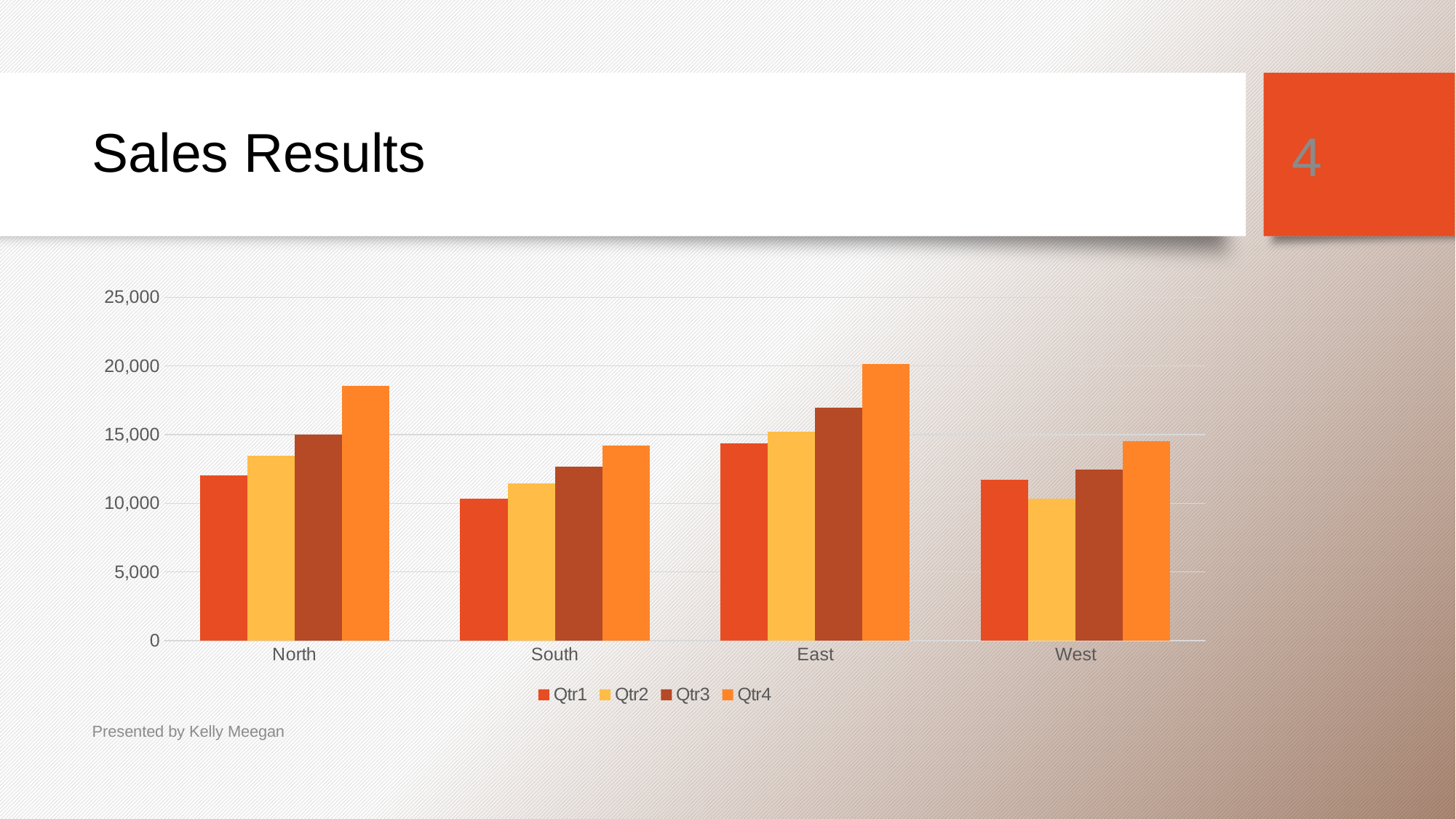
Which region has the lowest Qtr1 value? South Is the Qtr4 value for North greater or less than 15,000? greater What type of chart is shown on the slide? Bar chart Is the Qtr3 value for East greater or less than 15,000? greater What is the title of the chart on the slide? Sales Results Which is larger, the Qtr1 value for East or the Qtr1 value for West? East For the East region, do the values rise or fall from Qtr1 to Qtr4? rise How many regions (categories) are shown on the x axis? 4 How many series does the legend list? 4 Which is larger, the Qtr4 value for North or the Qtr4 value for South? North Which region has the highest Qtr4 value? East Is the Qtr2 value for West greater or less than 15,000? less